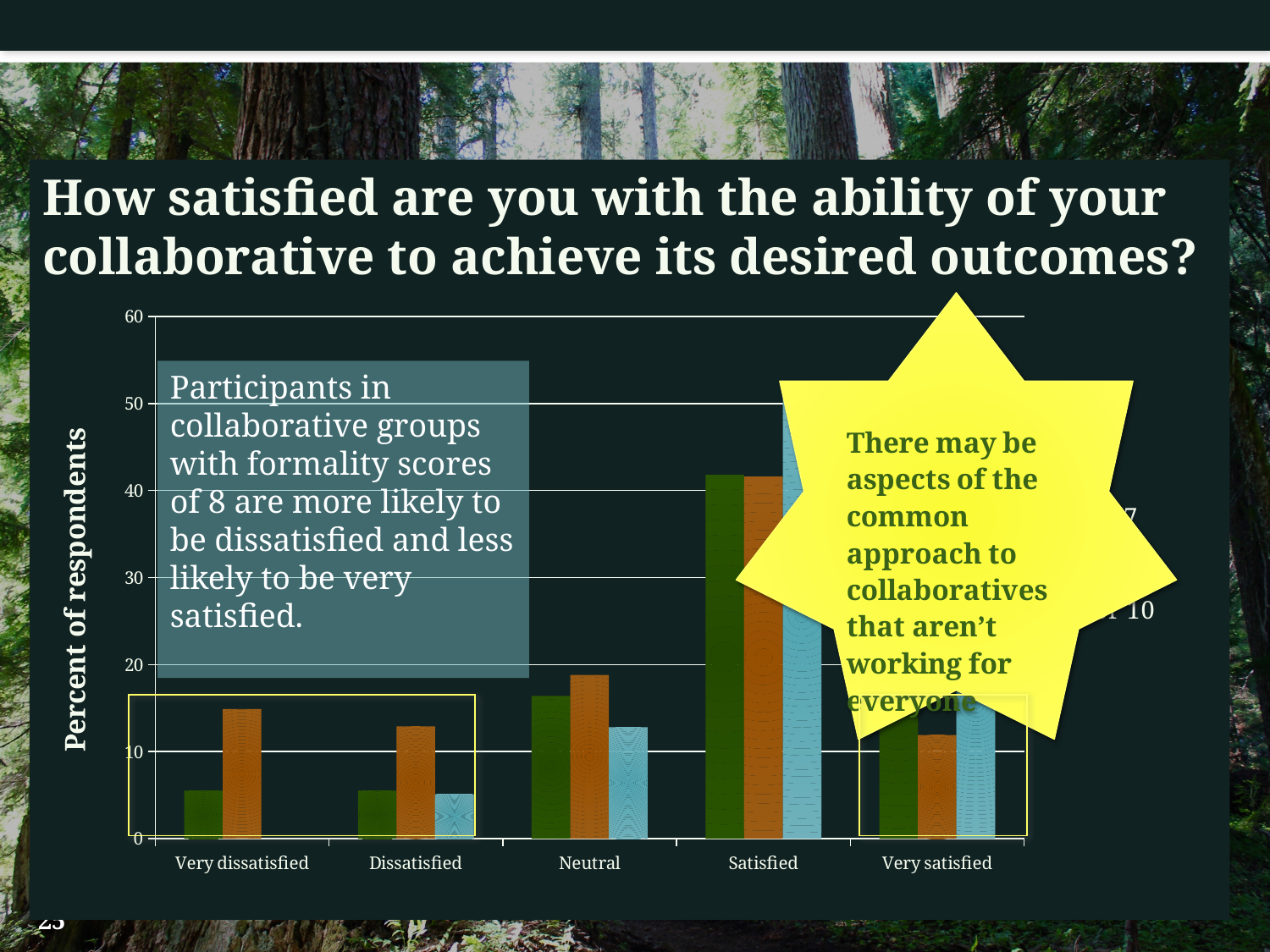
Which category has taller bars, Neutral or Satisfied? Satisfied Which category has the tallest bars in the chart? Satisfied Do the bar heights generally rise or fall from Very dissatisfied to Satisfied? rise What kind of chart is shown on the slide? bar chart What is the label of the y axis of the chart? Percent of respondents Is the tallest bar for Dissatisfied greater or less than 20? less Is the tallest bar for Satisfied greater or less than 40? greater What is the highest value shown on the y axis of the chart? 60 How many satisfaction categories are shown on the x axis of the chart? 5 Which category has taller bars, Dissatisfied or Neutral? Neutral Is the tallest bar for Very dissatisfied greater or less than 20? less